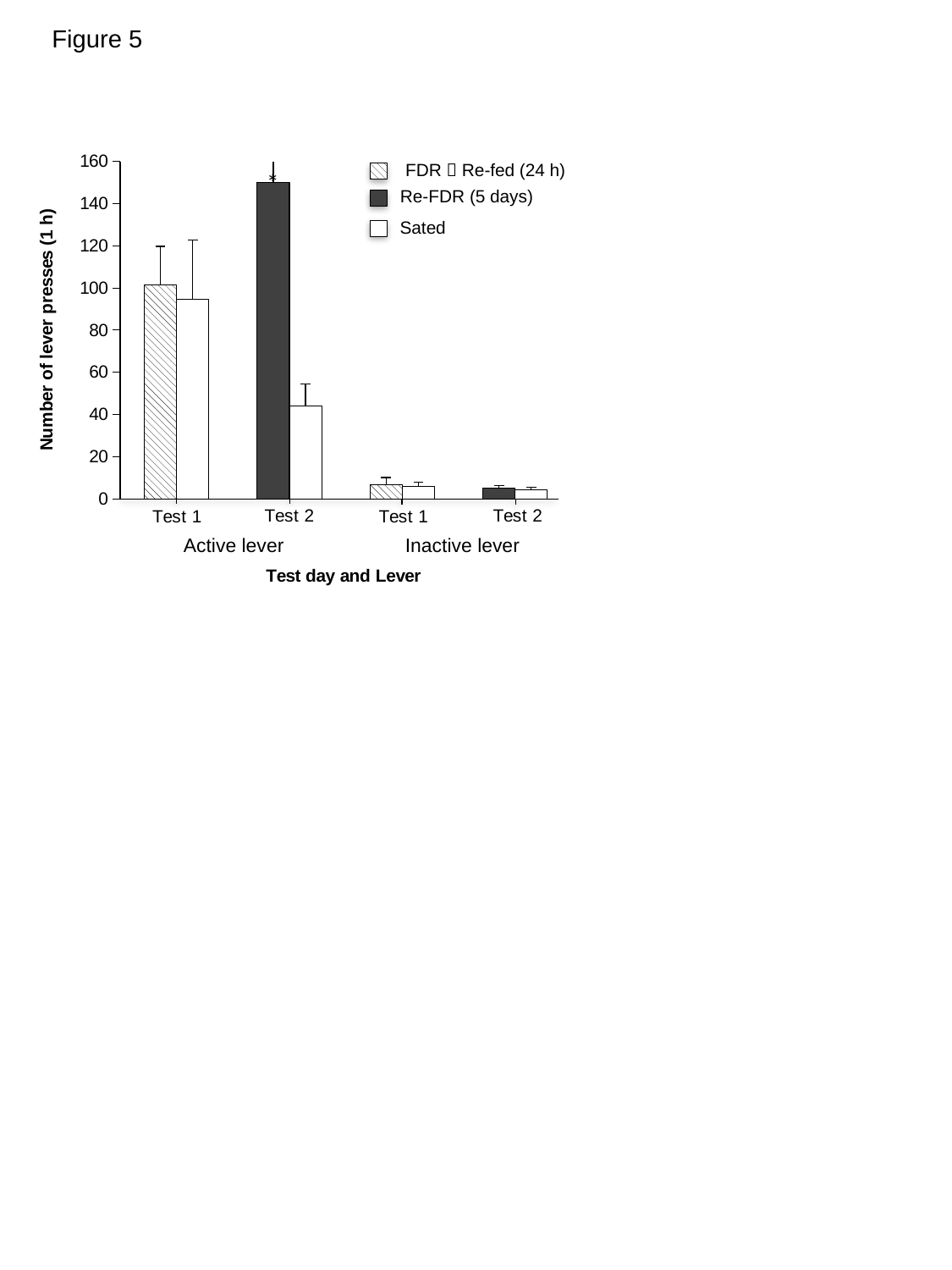
How many series does the legend list? 3 Is the value for Sated at Test 1 on the Inactive lever greater or less than 20? less Which bar is the highest in the chart? Re-FDR (5 days), Test 2, Active lever Which is larger: the Sated bar at Test 1 on the Active lever or the Sated bar at Test 2 on the Active lever? Test 1 on the Active lever Is the value for FDR → Re-fed (24 h) at Test 1 on the Active lever greater or less than 80? greater Is the value for Sated at Test 2 on the Active lever greater or less than 60? less At Test 2 on the Active lever, which is larger: Re-FDR (5 days) or Sated? Re-FDR (5 days) What is the label of the y axis? Number of lever presses (1 h) What is the label of the x axis? Test day and Lever What kind of chart is shown on the slide? bar chart How many test-day categories are shown along the x axis? 4